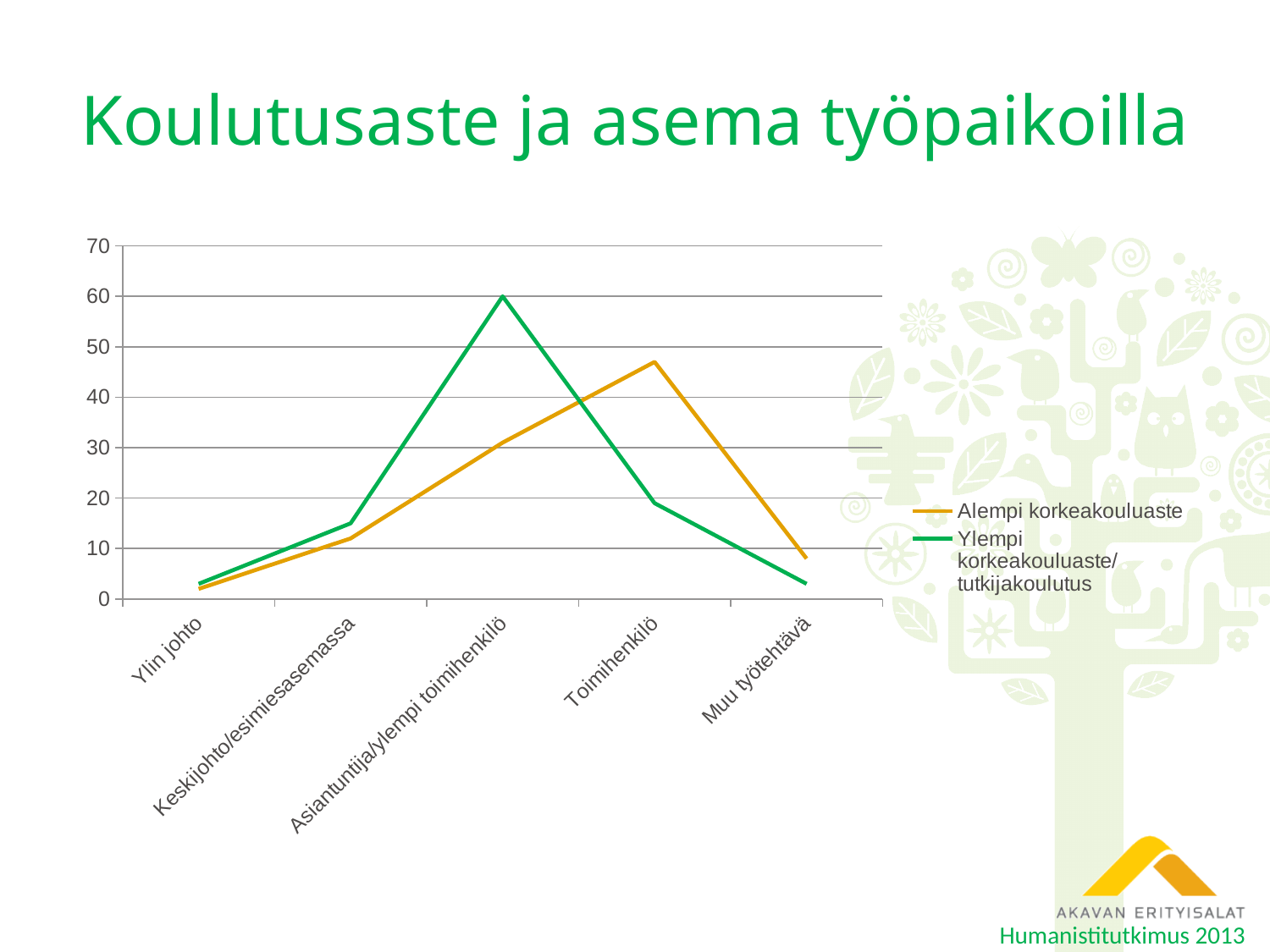
How many categories are shown on the x axis? 5 For Asiantuntija/ylempi toimihenkilö, which series has the larger value? Ylempi korkeakouluaste/tutkijakoulutus What is the title of the slide containing the chart? Koulutusaste ja asema työpaikoilla Is the value of Ylempi korkeakouluaste/tutkijakoulutus for Toimihenkilö greater or less than 30? less Is the value of Alempi korkeakouluaste for Toimihenkilö greater or less than 40? greater What is the value of the Ylempi korkeakouluaste/tutkijakoulutus series for Asiantuntija/ylempi toimihenkilö? 60 For which category does the Alempi korkeakouluaste series reach its highest value? Toimihenkilö For Toimihenkilö, which series has the larger value? Alempi korkeakouluaste For which category does the Ylempi korkeakouluaste/tutkijakoulutus series reach its highest value? Asiantuntija/ylempi toimihenkilö How many series does the legend list? 2 Which series is drawn in green? Ylempi korkeakouluaste/tutkijakoulutus What kind of chart is shown on the slide? line chart